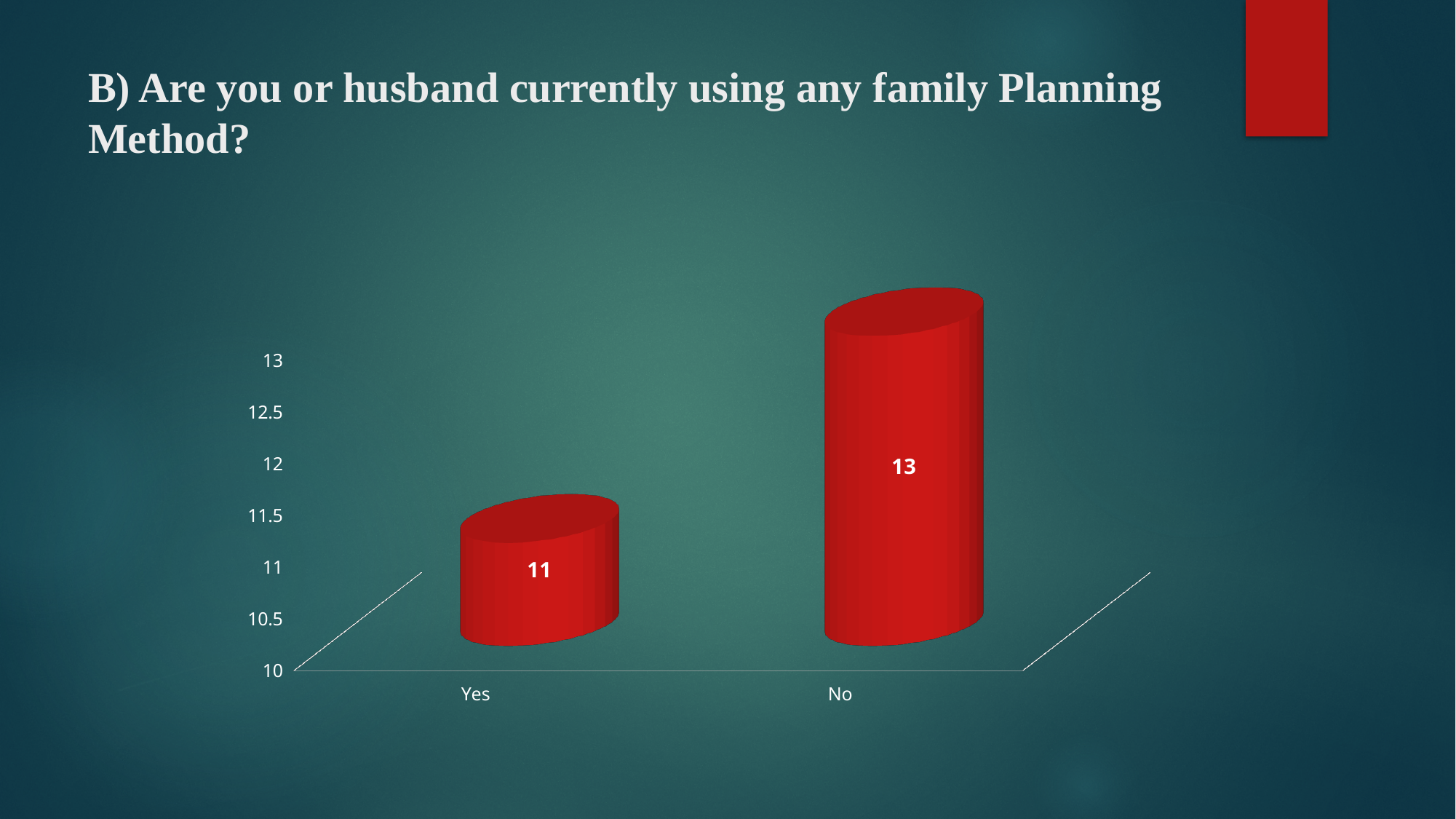
How many categories are shown on the x axis? 2 What is the value for No? 13 Is the value for Yes greater or less than 12? less Is the value for No greater or less than 12? greater Which is larger, the value for Yes or the value for No? No Do the values rise or fall from Yes to No? rise What kind of chart is shown on the slide? bar chart What colour are the bars in the chart? red What is the value for Yes? 11 Which category has the lowest value? Yes Which category has the highest value? No What is the difference between the values for No and Yes? 2